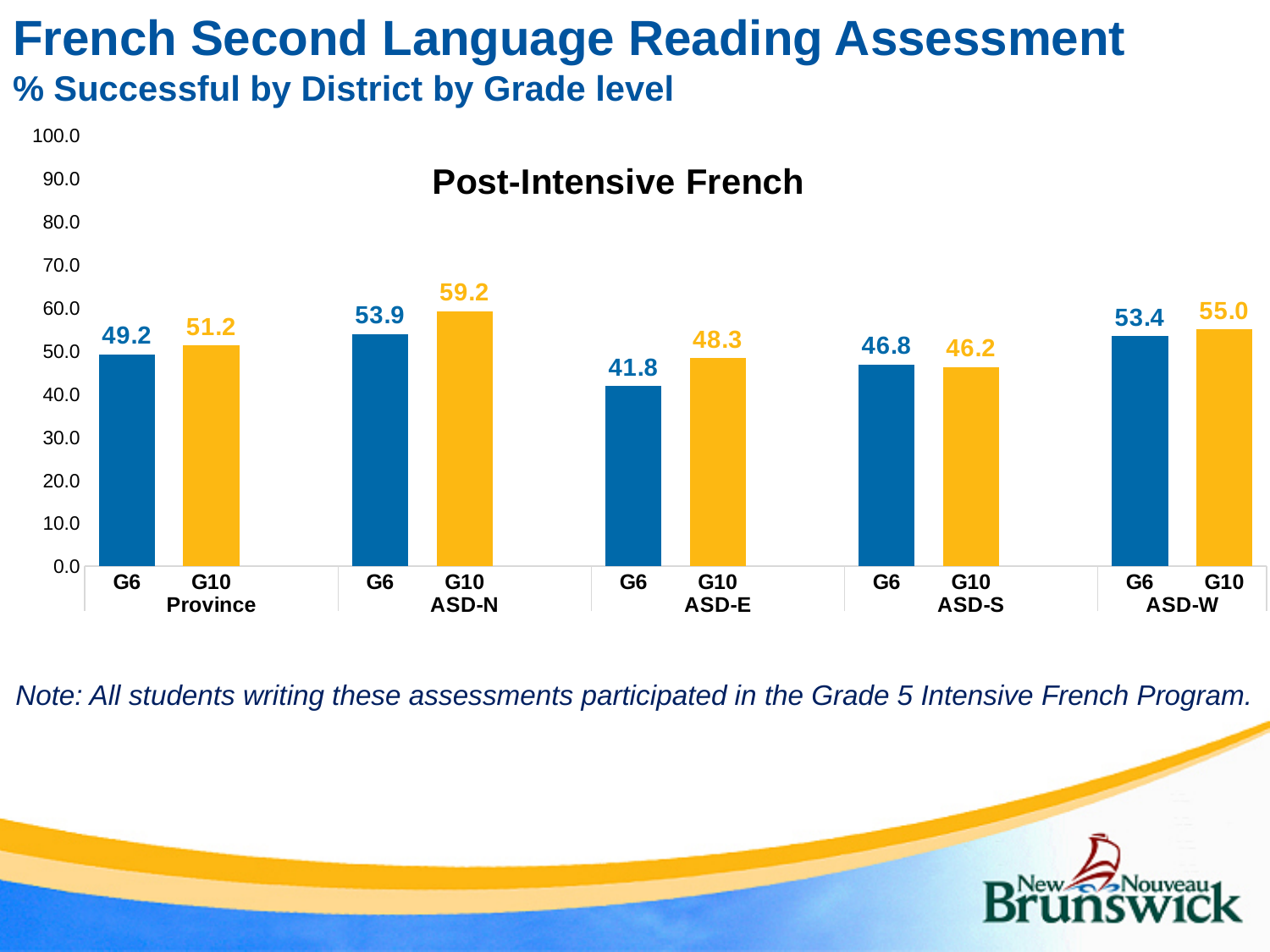
What is the difference between the G10 and G6 values for ASD-N? 5.3 Which district has the highest G10 value? ASD-N Which is larger for ASD-W, the G6 value or the G10 value? G10 Is the G6 value for ASD-E greater or less than 50.0? less What is the G6 value for ASD-N? 53.9 How many districts (including Province) are shown on the x axis? 5 What is the difference between the G6 and G10 values for ASD-S? 0.6 What is the G10 value for ASD-E? 48.3 Which district has the lowest G6 value? ASD-E What kind of chart is shown on the slide? bar chart What is the G6 value for the Province? 49.2 What is the title printed inside the chart area? Post-Intensive French